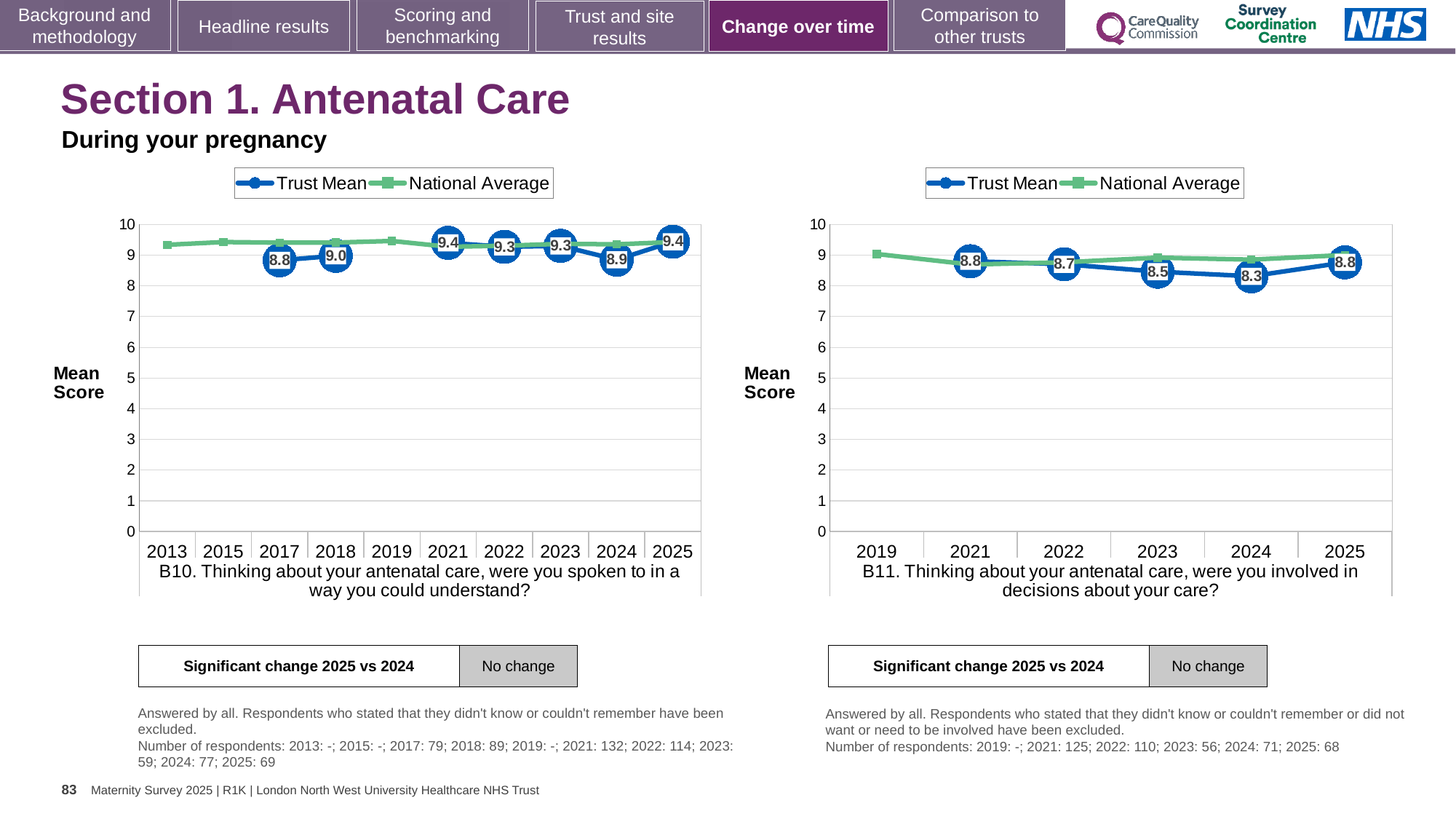
In the left chart (B10), is the National Average value for 2013 greater or less than 9? greater In the right chart (B11), does the Trust Mean score rise or fall from 2021 to 2024? Fall In the left chart (B10), which year has the lowest labelled Trust Mean score? 2017 In the left chart (B10), is the Trust Mean score higher in 2021 or in 2017? 2021 How many series does the legend of the left chart (B10) list? 2 In the left chart (B10), what is the difference between the Trust Mean scores for 2025 and 2024? 0.5 What kind of chart is the right chart (B11)? Line chart In the left chart (B10), what is the Trust Mean score for 2018? 9.0 In the right chart (B11), what is the difference between the Trust Mean scores for 2021 and 2024? 0.5 In the right chart (B11), what is the Trust Mean score for 2023? 8.5 How many years are shown on the x axis of the right chart (B11)? 6 In the right chart (B11), which year has the lowest Trust Mean score? 2024